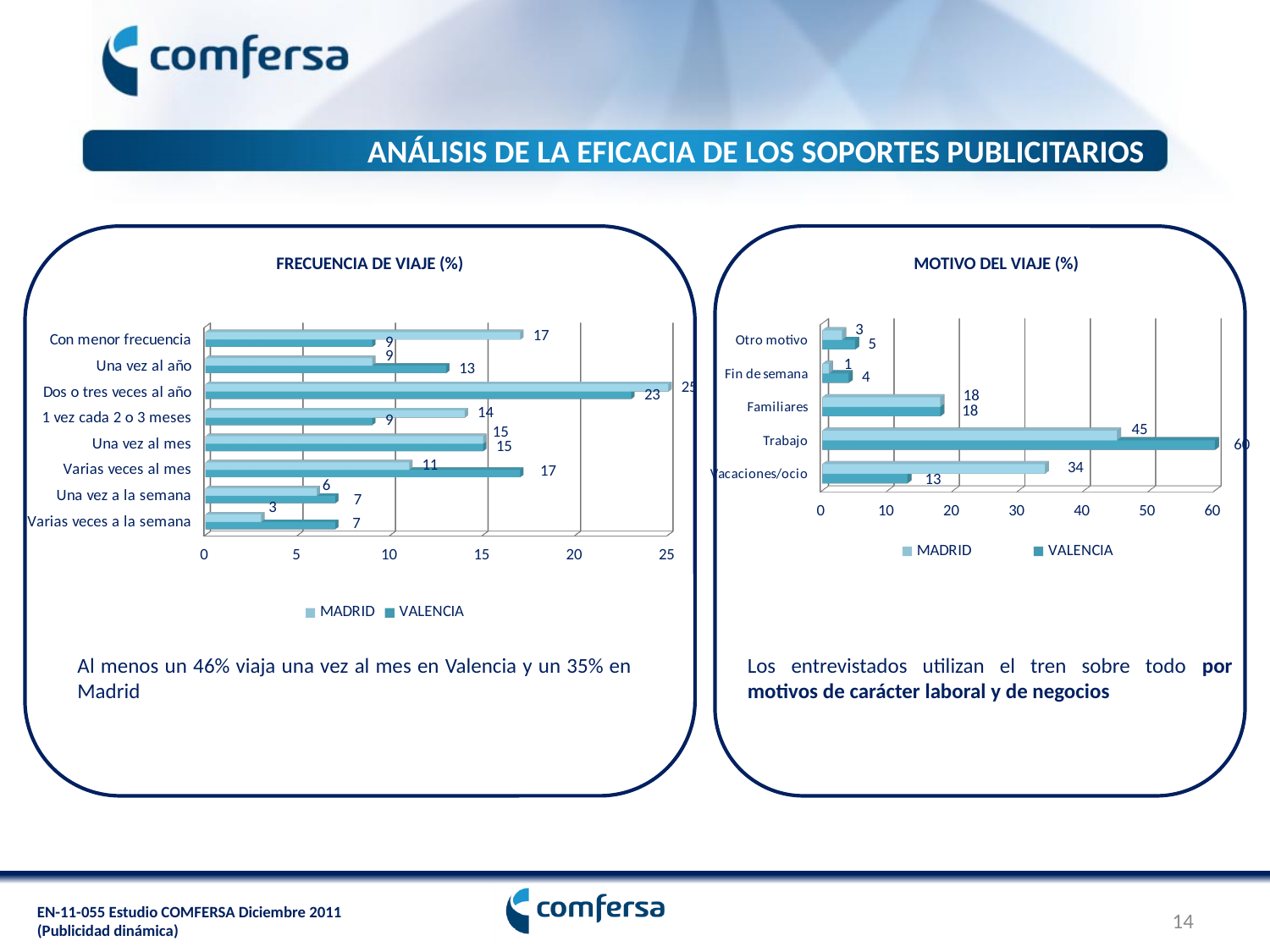
In the FRECUENCIA DE VIAJE (%) chart, how many categories are shown on the vertical axis? 8 In the FRECUENCIA DE VIAJE (%) chart, which category has the lowest MADRID value? Varias veces a la semana In the MOTIVO DEL VIAJE (%) chart, what is the VALENCIA value for 'Trabajo'? 60 In the MOTIVO DEL VIAJE (%) chart, which is larger for 'Vacaciones/ocio', the MADRID value or the VALENCIA value? MADRID What type of chart is the MOTIVO DEL VIAJE (%) chart? Bar chart In the MOTIVO DEL VIAJE (%) chart, what is the MADRID value for 'Vacaciones/ocio'? 34 In the MOTIVO DEL VIAJE (%) chart, how many series does the legend list? 2 In the FRECUENCIA DE VIAJE (%) chart, what is the difference between the MADRID and VALENCIA values for 'Una vez al año'? 4 In the MOTIVO DEL VIAJE (%) chart, what is the difference between the VALENCIA and MADRID values for 'Trabajo'? 15 In the FRECUENCIA DE VIAJE (%) chart, what is the MADRID value for 'Con menor frecuencia'? 17 In the FRECUENCIA DE VIAJE (%) chart, which category has the highest MADRID value? Dos o tres veces al año In the FRECUENCIA DE VIAJE (%) chart, what is the VALENCIA value for 'Varias veces al mes'? 17